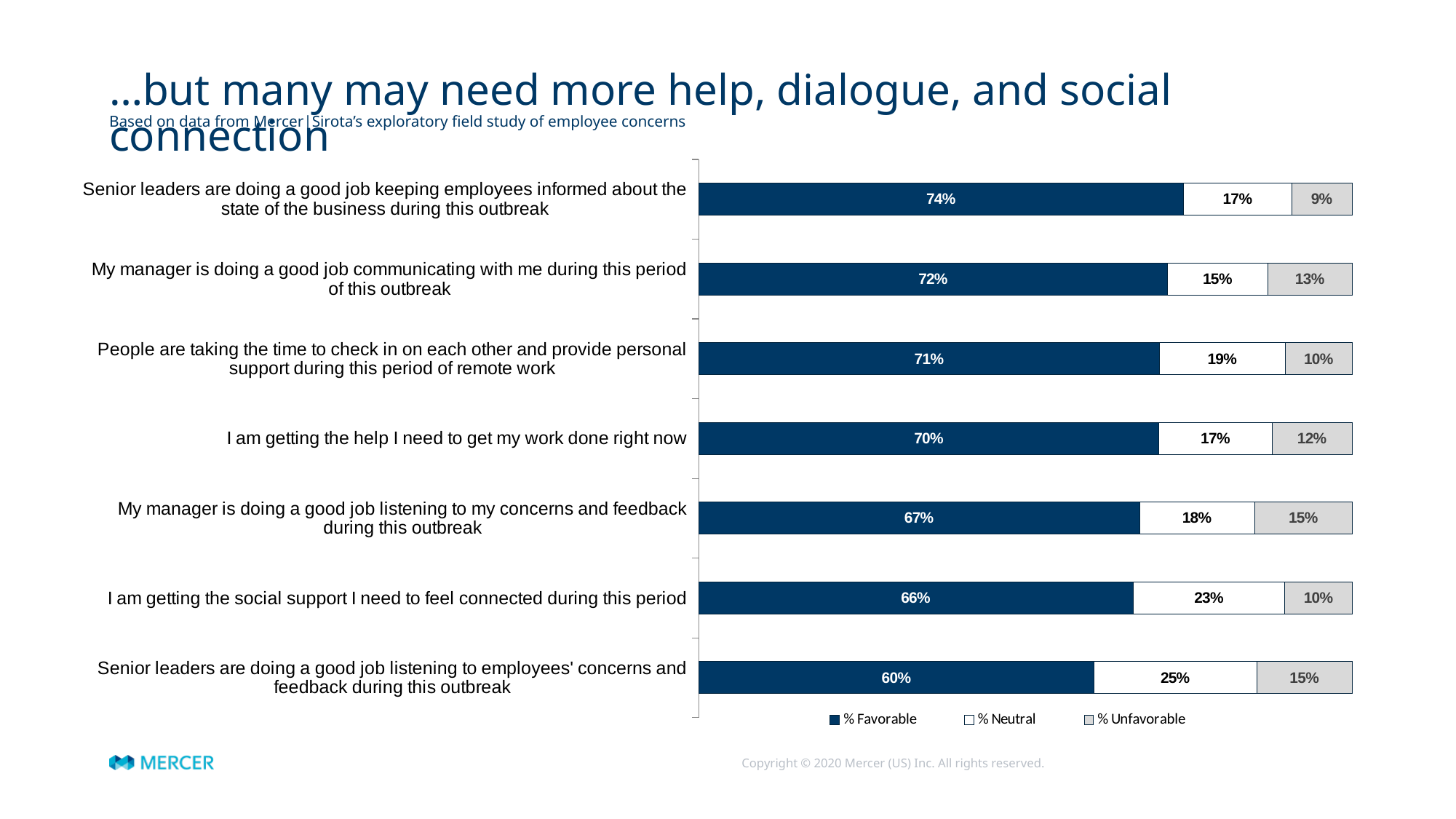
What kind of chart is shown on the slide? Stacked horizontal bar chart Which statement has the lowest % Favorable value? Senior leaders are doing a good job listening to employees' concerns and feedback during this outbreak What is the % Favorable value for "I am getting the help I need to get my work done right now"? 70% What is the difference in % Favorable between "Senior leaders are doing a good job keeping employees informed about the state of the business during this outbreak" and "Senior leaders are doing a good job listening to employees' concerns and feedback during this outbreak"? 14% What is the total of the stacked bar for "People are taking the time to check in on each other and provide personal support during this period of remote work"? 100% What is the % Neutral value for "I am getting the social support I need to feel connected during this period"? 23% Which series is shown in dark blue in the legend? % Favorable What is the % Unfavorable value for "My manager is doing a good job communicating with me during this period of this outbreak"? 13% Which has a larger % Neutral value: "Senior leaders are doing a good job listening to employees' concerns and feedback during this outbreak" or "My manager is doing a good job communicating with me during this period of this outbreak"? Senior leaders are doing a good job listening to employees' concerns and feedback during this outbreak How many statements are shown in the chart? 7 Which statement has the highest % Favorable value? Senior leaders are doing a good job keeping employees informed about the state of the business during this outbreak How many series does the legend list? 3